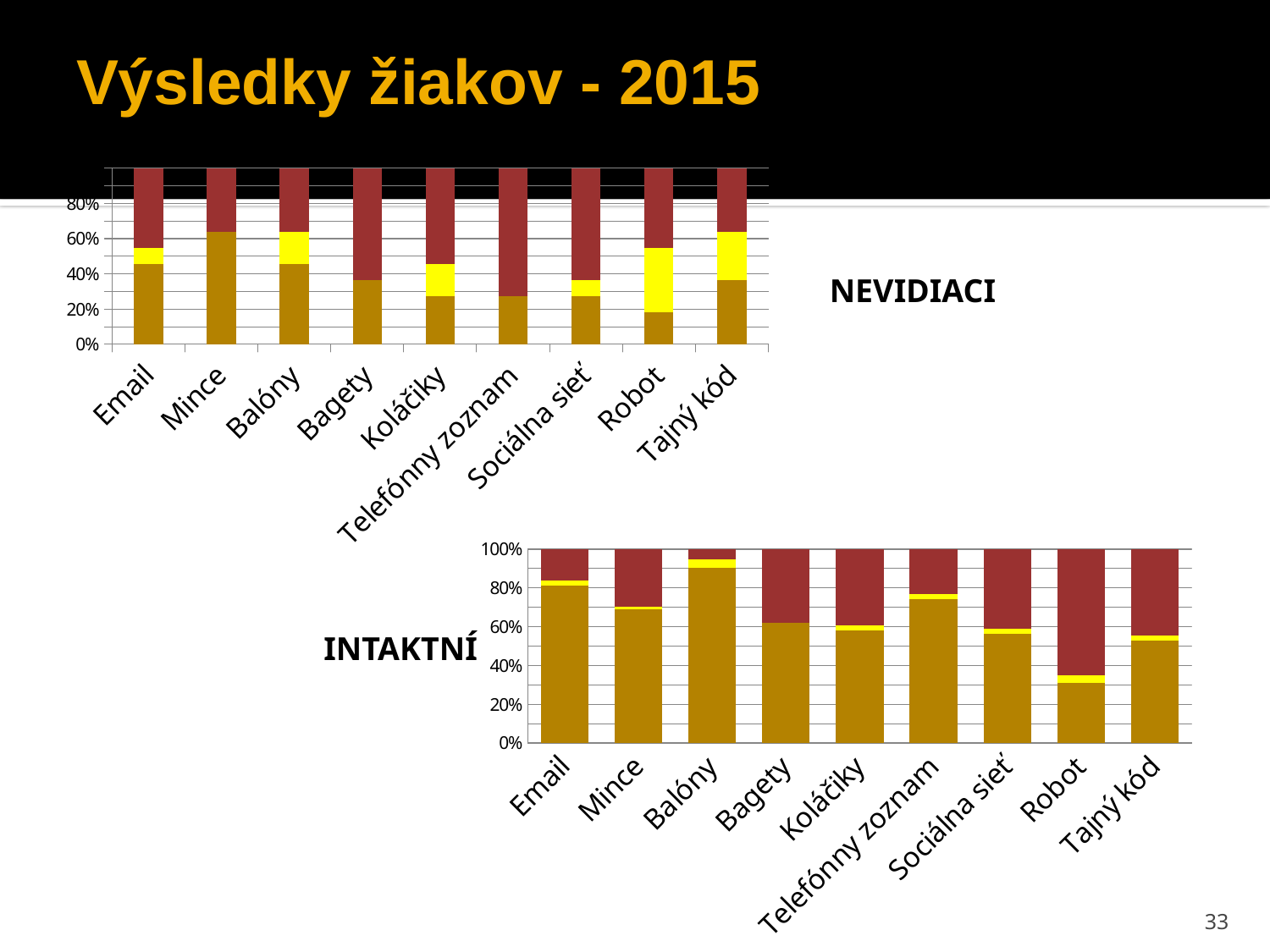
In the INTAKTNÍ chart, is the gold (bottom) segment for Robot greater or less than 40%? less What is the title of the slide containing the two charts? Výsledky žiakov - 2015 How many categories are shown on the x axis of the INTAKTNÍ chart? 9 In the INTAKTNÍ chart, is the gold (bottom) segment for Telefónny zoznam greater or less than 60%? greater In the INTAKTNÍ chart, which category has the tallest gold (bottom) segment? Balóny In the NEVIDIACI chart, which category has the shortest gold (bottom) segment? Robot In the INTAKTNÍ chart, which category has the shortest gold (bottom) segment? Robot In the NEVIDIACI chart, which has the larger gold (bottom) segment, Mince or Robot? Mince In the INTAKTNÍ chart, which has the larger gold (bottom) segment, Balóny or Bagety? Balóny What kind of chart is the NEVIDIACI chart at the top of the slide? stacked bar chart In the NEVIDIACI chart, which category has the tallest gold (bottom) segment? Mince In the NEVIDIACI chart, is the gold (bottom) segment for Koláčiky greater or less than 40%? less